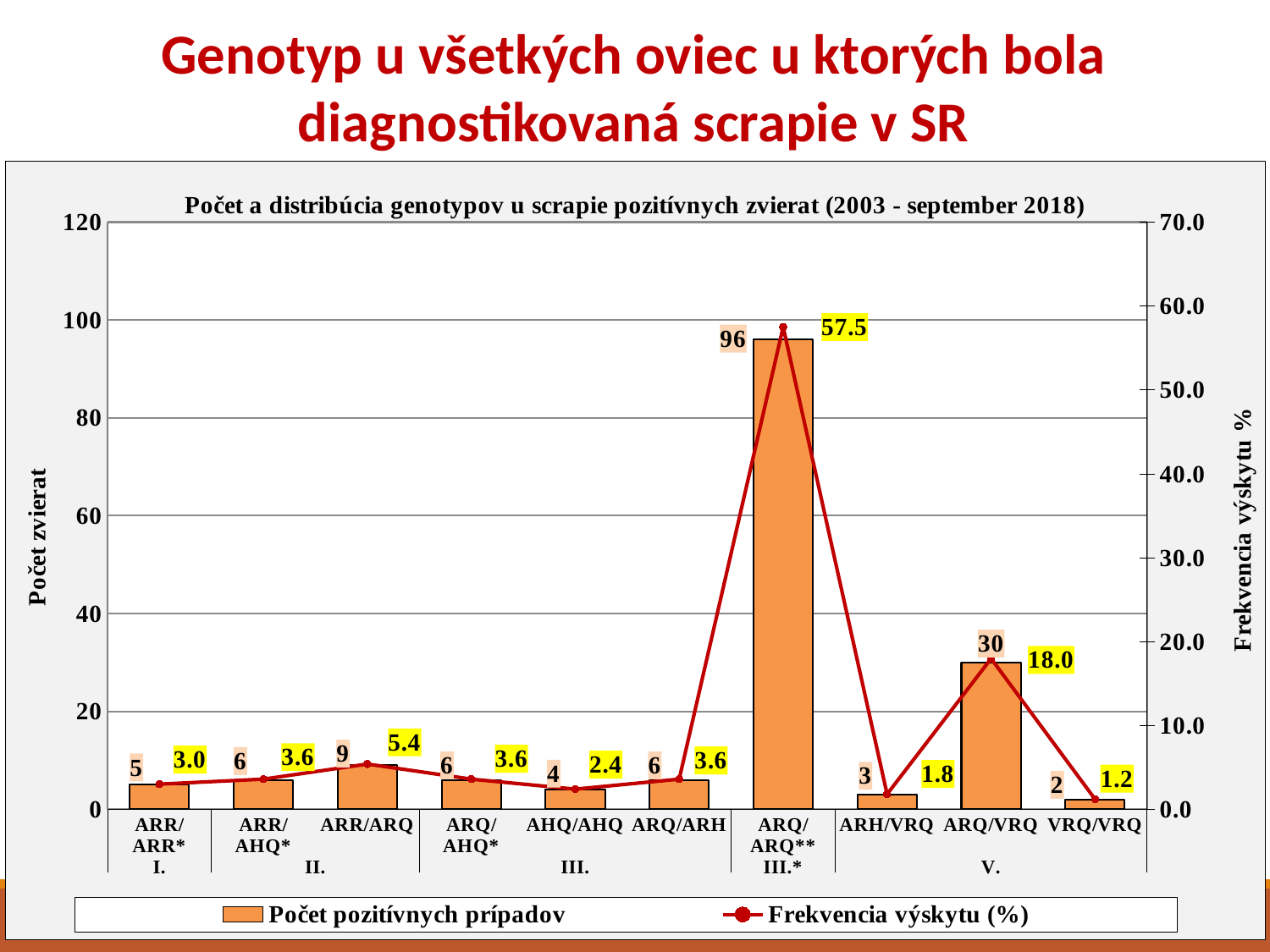
What is the difference in the number of positive cases between ARQ/ARQ** and ARQ/VRQ? 66 What is the frequency of occurrence (Frekvencia výskytu) for the ARQ/VRQ genotype? 18.0 What is the frequency of occurrence (%) for the AHQ/AHQ genotype? 2.4 How many genotype categories are shown on the x axis? 10 Which genotype has more positive cases, ARR/ARQ or ARH/VRQ? ARR/ARQ What is the number of positive cases for the ARR/ARQ genotype? 9 What kind of chart is shown on the slide? Combined bar and line chart Which genotype has the highest number of positive cases? ARQ/ARQ** Which genotype has the lowest frequency of occurrence (%)? VRQ/VRQ What is the number of positive cases (Počet pozitívnych prípadov) for the ARQ/ARQ** genotype? 96 What is the label of the right-hand vertical axis? Frekvencia výskytu % How many series does the legend list? 2